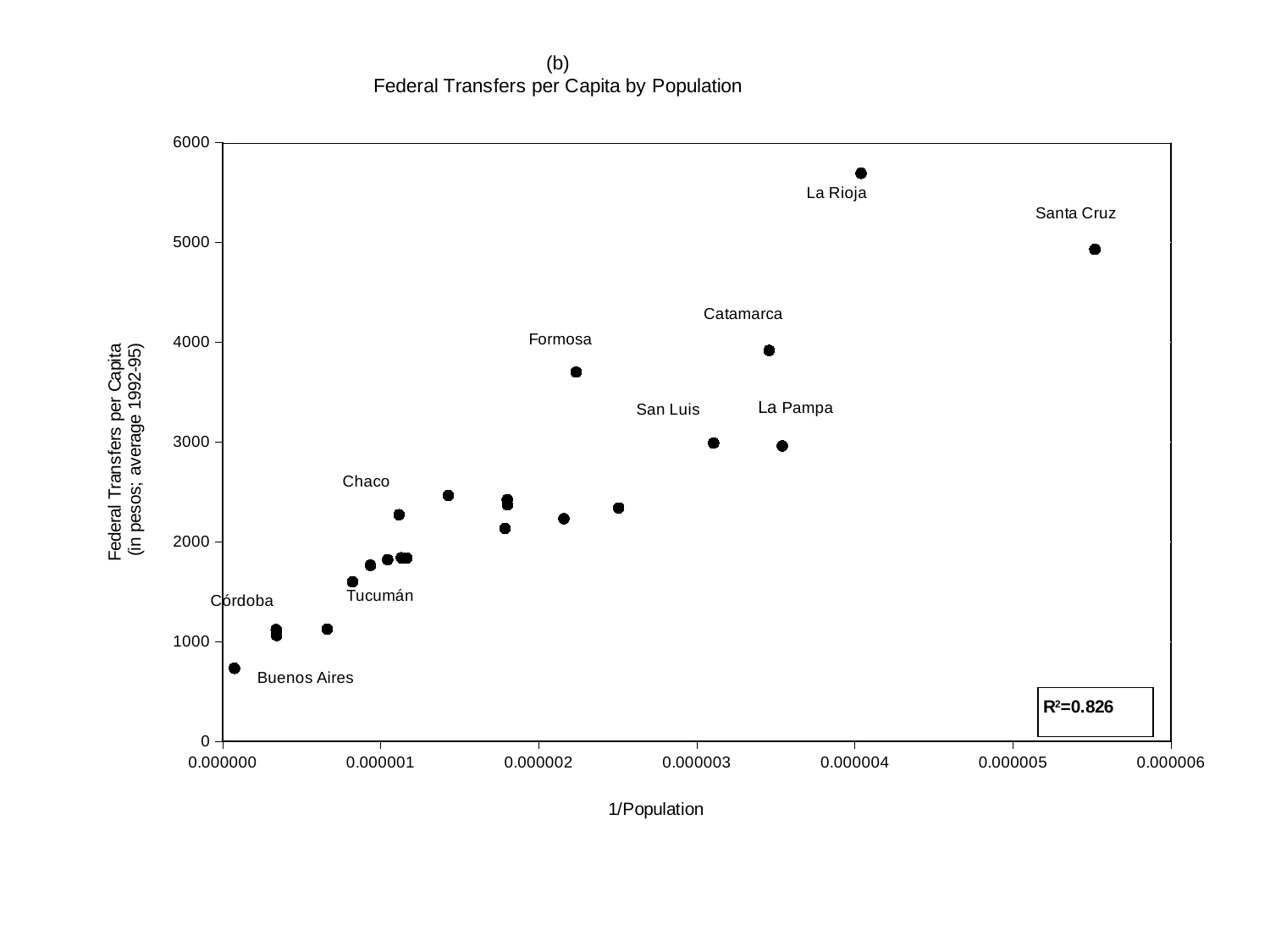
What R-squared value is printed on the chart? R²=0.826 Which labeled province has the highest federal transfers per capita? La Rioja Is the value of federal transfers per capita for Formosa greater or less than 4000? less Do federal transfers per capita generally rise or fall as 1/Population increases along the x axis? rise Which labeled province has the largest value of 1/Population? Santa Cruz What kind of chart is shown on the slide? scatter plot Which labeled province has the lowest federal transfers per capita? Buenos Aires Is the value of federal transfers per capita for La Rioja greater or less than 5000? greater Is the value of federal transfers per capita for Chaco greater or less than 2000? greater Which has higher federal transfers per capita, La Rioja or Santa Cruz? La Rioja What is the title of the chart? Federal Transfers per Capita by Population